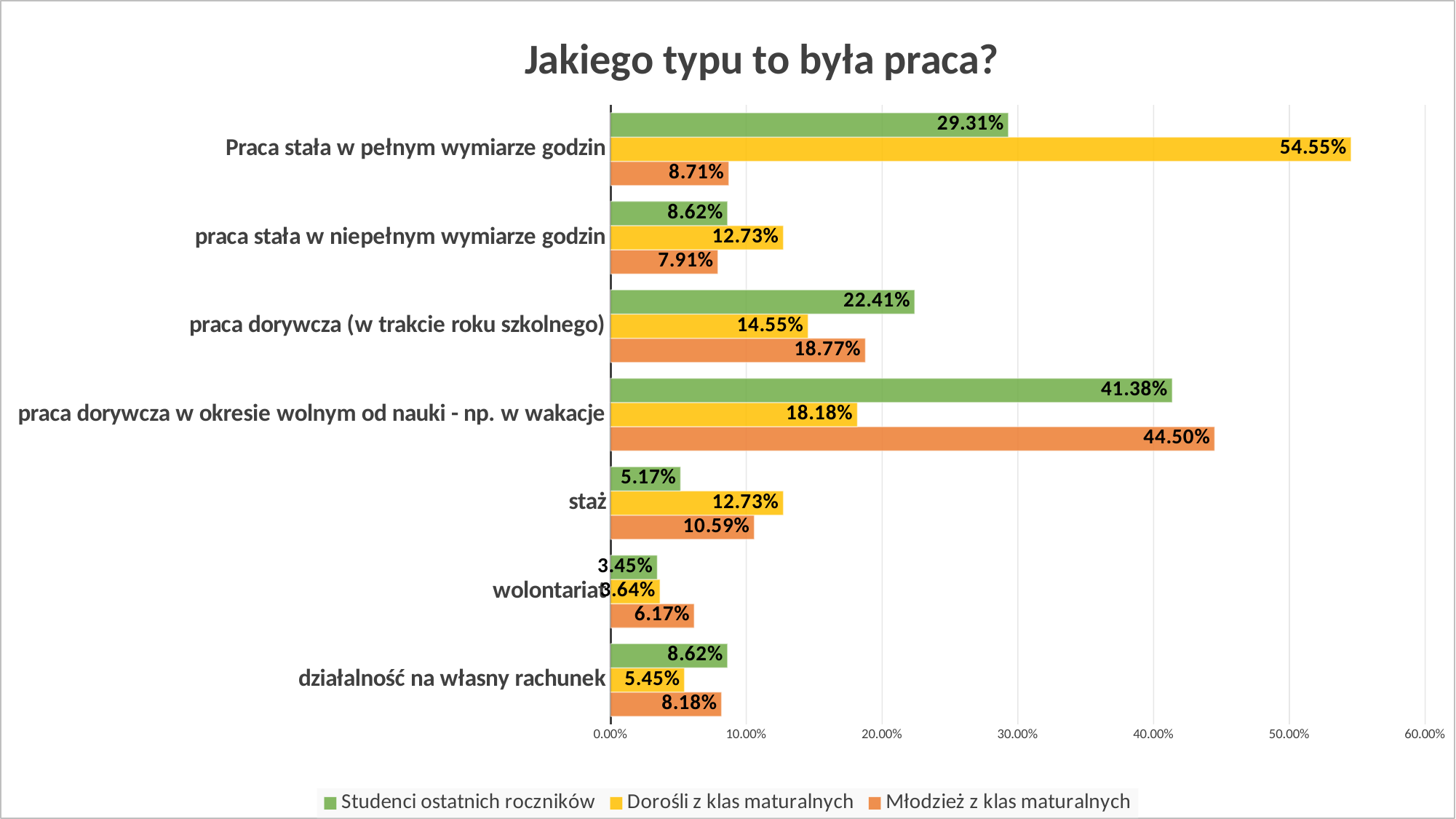
What is the value for Dorośli z klas maturalnych in the category 'Praca stała w pełnym wymiarze godzin'? 54.55% How many categories are shown on the chart? 7 What type of chart is shown on the slide? bar chart Which category has the highest value for Studenci ostatnich roczników? praca dorywcza w okresie wolnym od nauki - np. w wakacje Is the value for Dorośli z klas maturalnych in 'Praca stała w pełnym wymiarze godzin' greater or less than 50.00%? greater What is the title of the chart? Jakiego typu to była praca? In the category 'praca dorywcza (w trakcie roku szkolnego)', which is larger: the value for Studenci ostatnich roczników or for Dorośli z klas maturalnych? Studenci ostatnich roczników What is the value for Studenci ostatnich roczników in the category 'staż'? 5.17% How many series does the legend list? 3 What is the difference between the Dorośli z klas maturalnych and Studenci ostatnich roczników values for 'Praca stała w pełnym wymiarze godzin'? 25.24% What is the value for Młodzież z klas maturalnych in the category 'praca dorywcza w okresie wolnym od nauki - np. w wakacje'? 44.50% Which category has the lowest value for Młodzież z klas maturalnych? wolontariat